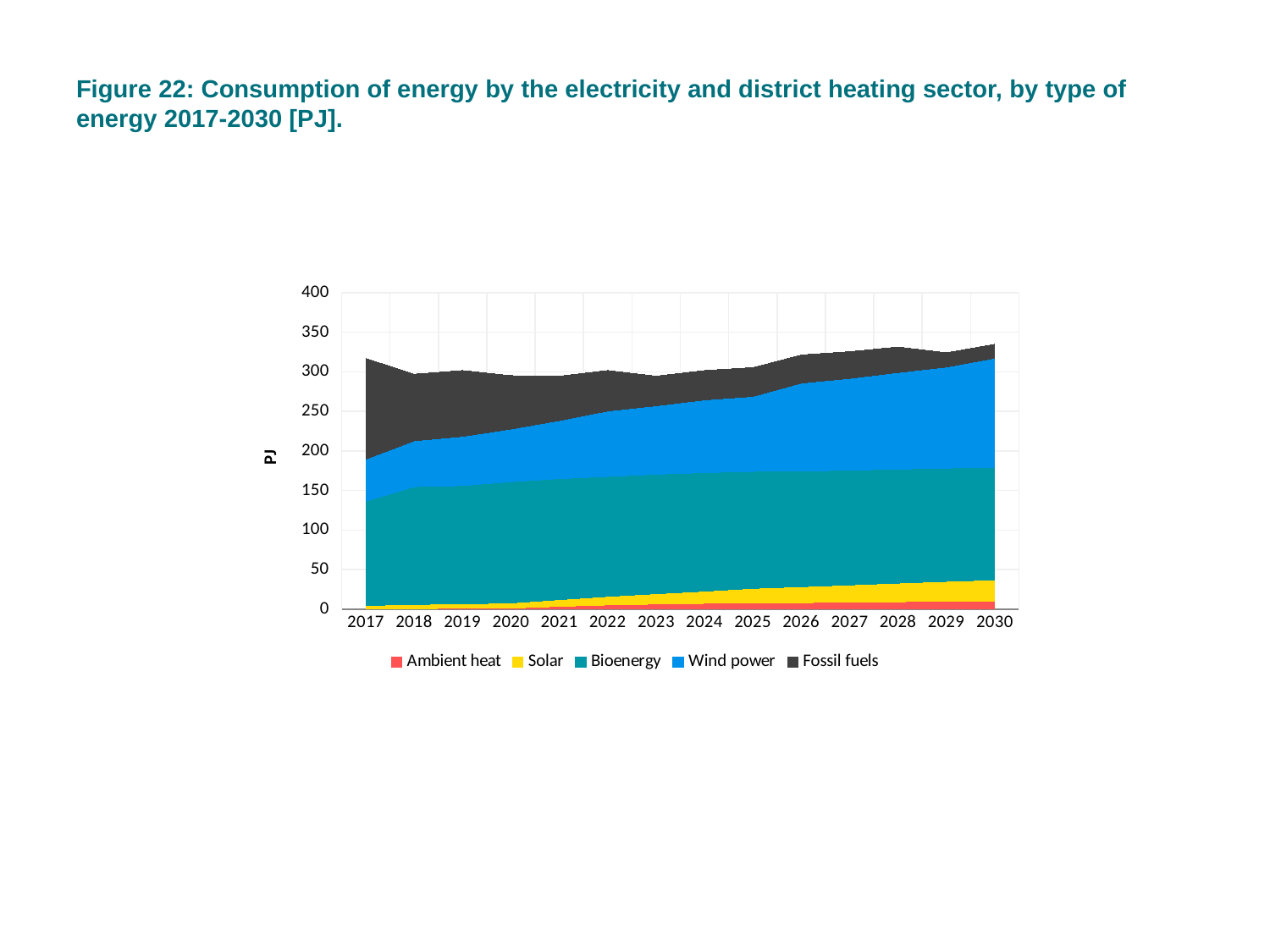
Is the total consumption in 2030 greater or less than 350? less How many series does the legend list? 5 Does the Wind power area get thicker or thinner from 2017 to 2030? thicker What is the label on the vertical axis? PJ What kind of chart is shown on the slide? Stacked area chart Which series is shown at the top of the stack (the dark grey area)? Fossil fuels Is the total consumption in 2030 greater or less than 300? greater Is the total consumption in 2017 greater or less than 300? greater How many years are shown along the x axis? 14 Is the total consumption in 2030 larger or smaller than in 2017? larger Does the Fossil fuels area get thicker or thinner from 2017 to 2030? thinner Is the Fossil fuels area thicker in 2017 or in 2030? 2017